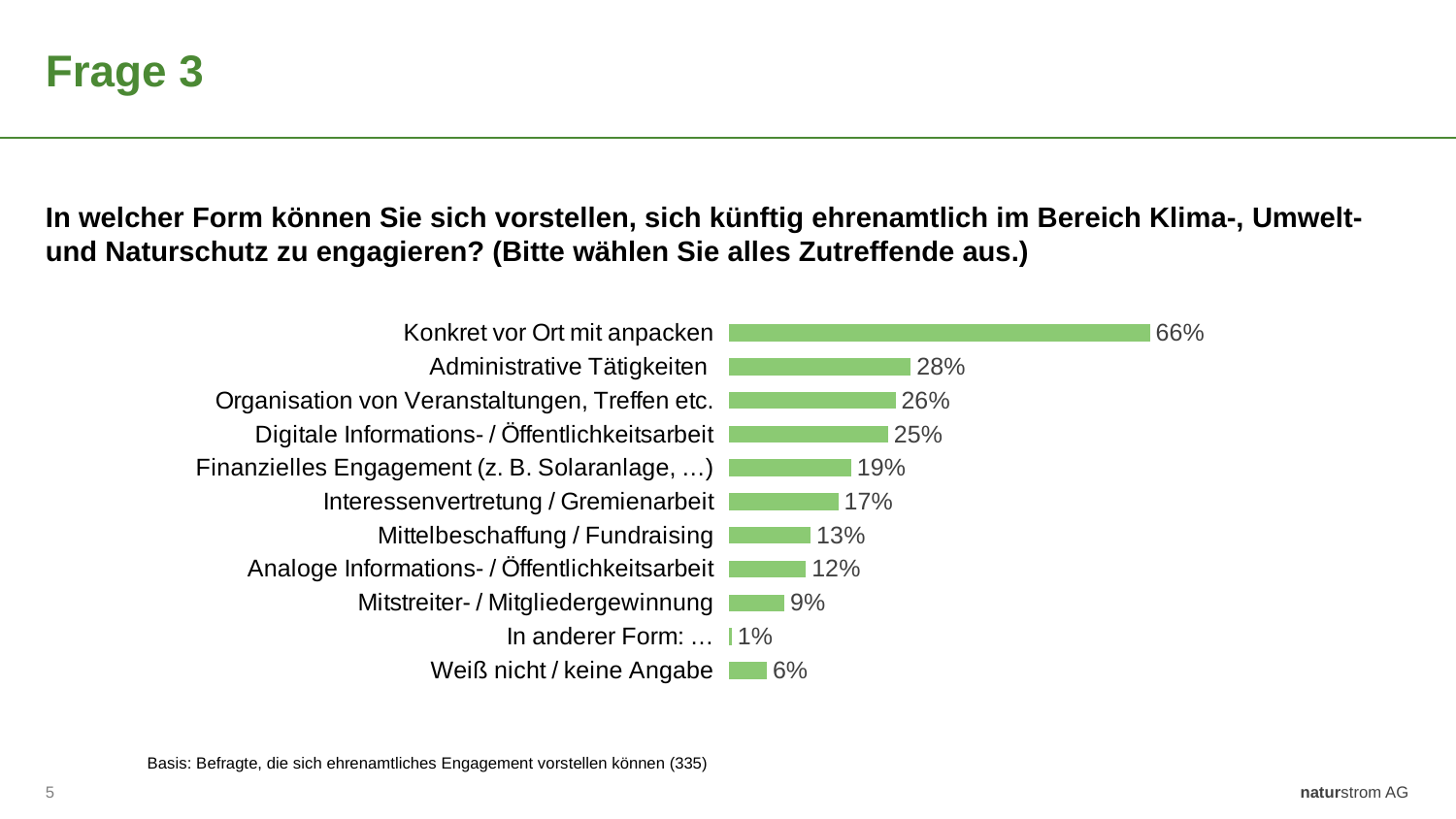
What is the value for "Konkret vor Ort mit anpacken"? 66% What is the basis (number of respondents) stated below the chart? 335 What is the value for "Weiß nicht / keine Angabe"? 6% What is the difference between "Finanzielles Engagement (z. B. Solaranlage, …)" and "Mitstreiter- / Mitgliedergewinnung"? 10% What kind of chart is shown on the slide? Bar chart Which category has the highest value? Konkret vor Ort mit anpacken What is the value for "Administrative Tätigkeiten"? 28% Which is larger: "Digitale Informations- / Öffentlichkeitsarbeit" or "Analoge Informations- / Öffentlichkeitsarbeit"? Digitale Informations- / Öffentlichkeitsarbeit How many categories are shown in the chart? 11 What is the value for "Mittelbeschaffung / Fundraising"? 13% What is the difference between "Konkret vor Ort mit anpacken" and "Administrative Tätigkeiten"? 38% Which category has the lowest value? In anderer Form: …